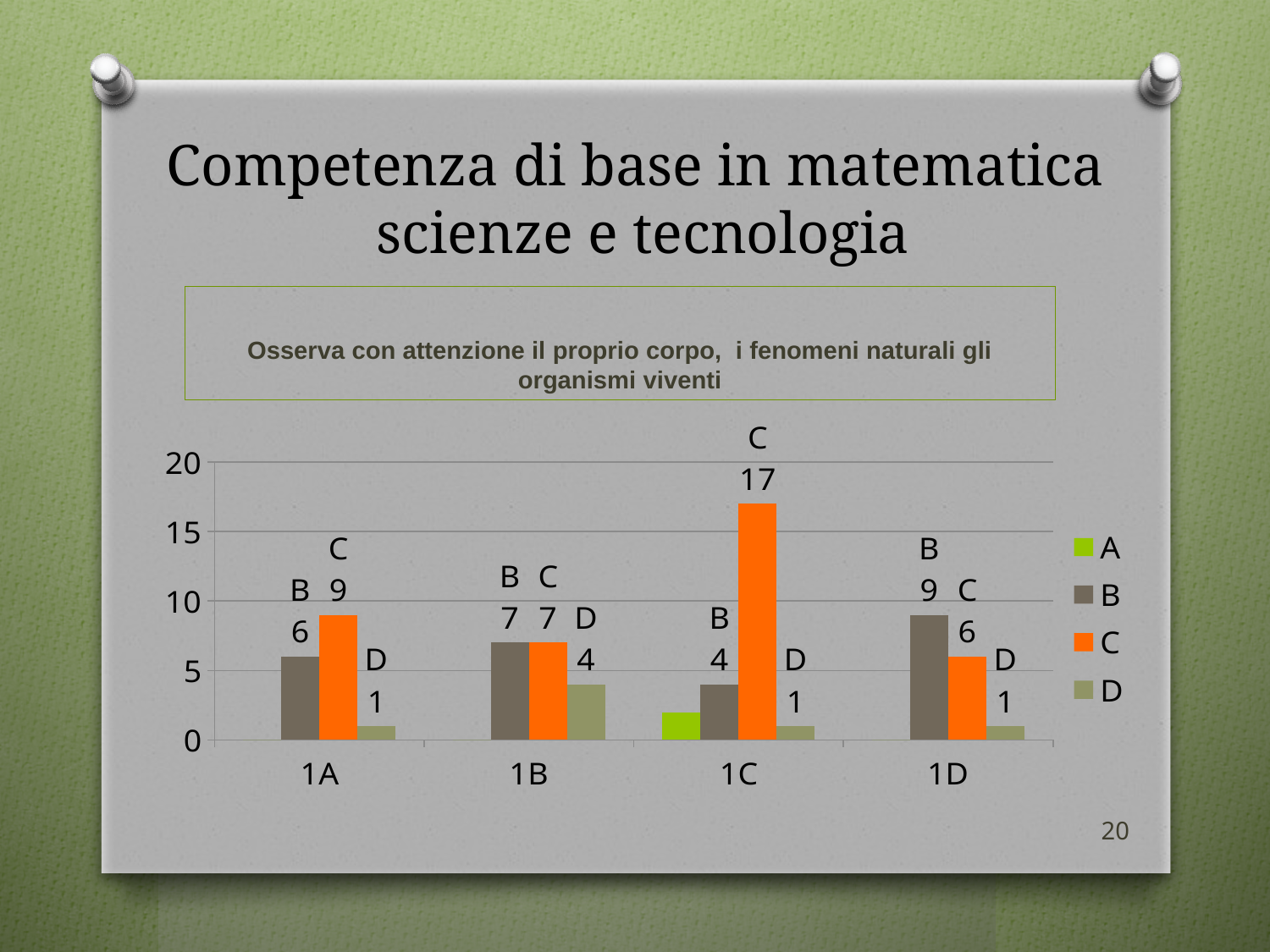
What is the value of series D for class 1B? 4 What kind of chart is shown on the slide? bar chart Which is larger for class 1D, the B value or the C value? B What is the value of series C for class 1D? 6 What is the value of series B for class 1A? 6 What is the value of series C for class 1C? 17 What is the difference between the C value and the B value for class 1C? 13 How many classes are shown on the x axis? 4 Which class has the highest value for series C? 1C Which class has the lowest value for series B? 1C Is the value of series A for class 1C greater or less than 5? less How many series does the legend list? 4